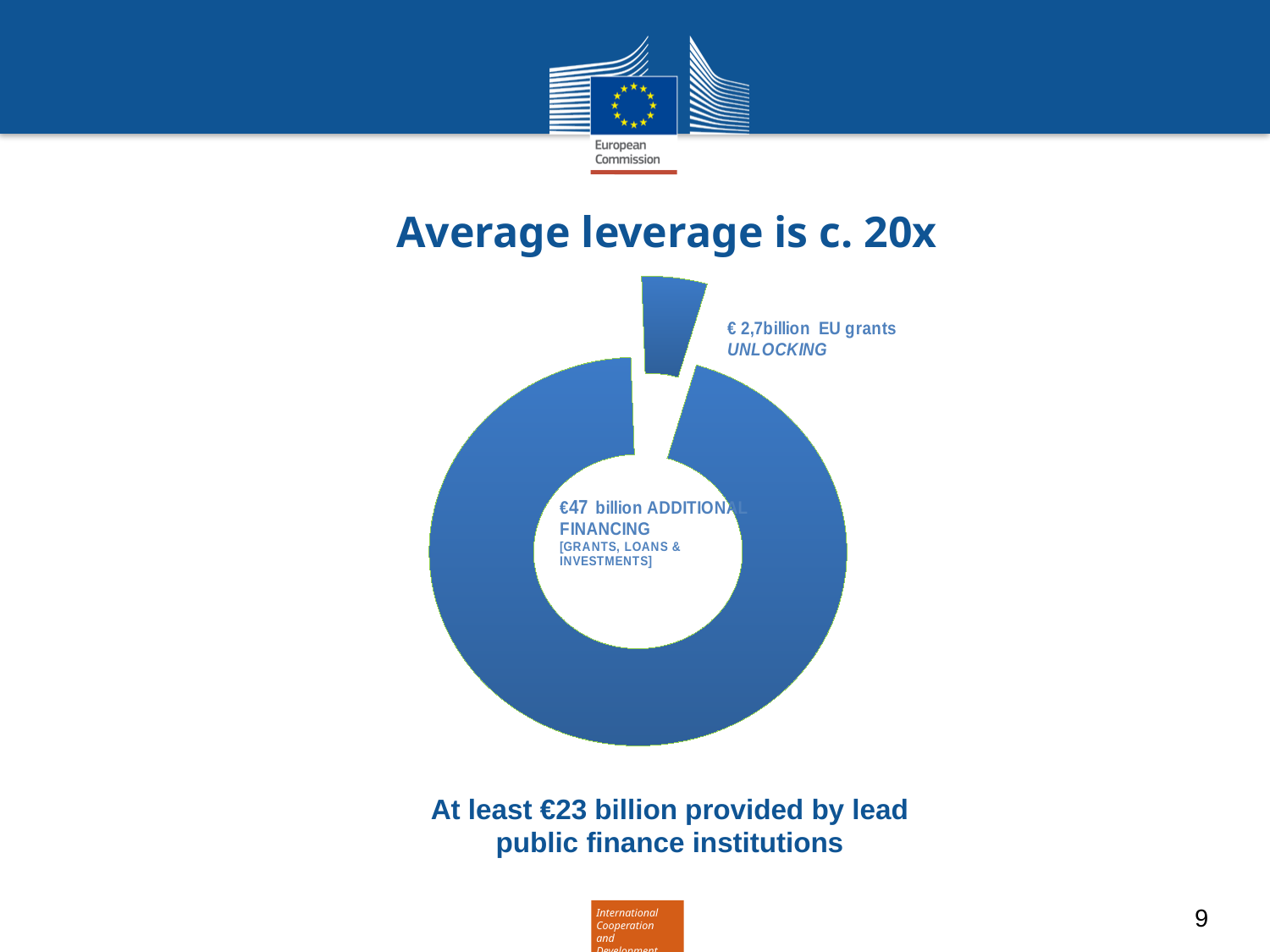
Which is larger, the EU grants slice or the additional financing slice? additional financing Which slice is the largest in the doughnut chart? €47 billion additional financing What is the value of the EU grants slice? € 2,7billion What is the title shown above the chart? Average leverage is c. 20x What is the difference between the additional financing value and the EU grants value? €44,3 billion What is the combined total of the two slices in the doughnut chart? €49,7 billion What is the value of the additional financing slice? €47 billion What does the bracketed text under the additional financing label say? [GRANTS, LOANS & INVESTMENTS] Which slice is the smallest in the doughnut chart? € 2,7billion EU grants What kind of chart is shown on the slide? doughnut chart How many slices does the doughnut chart have? 2